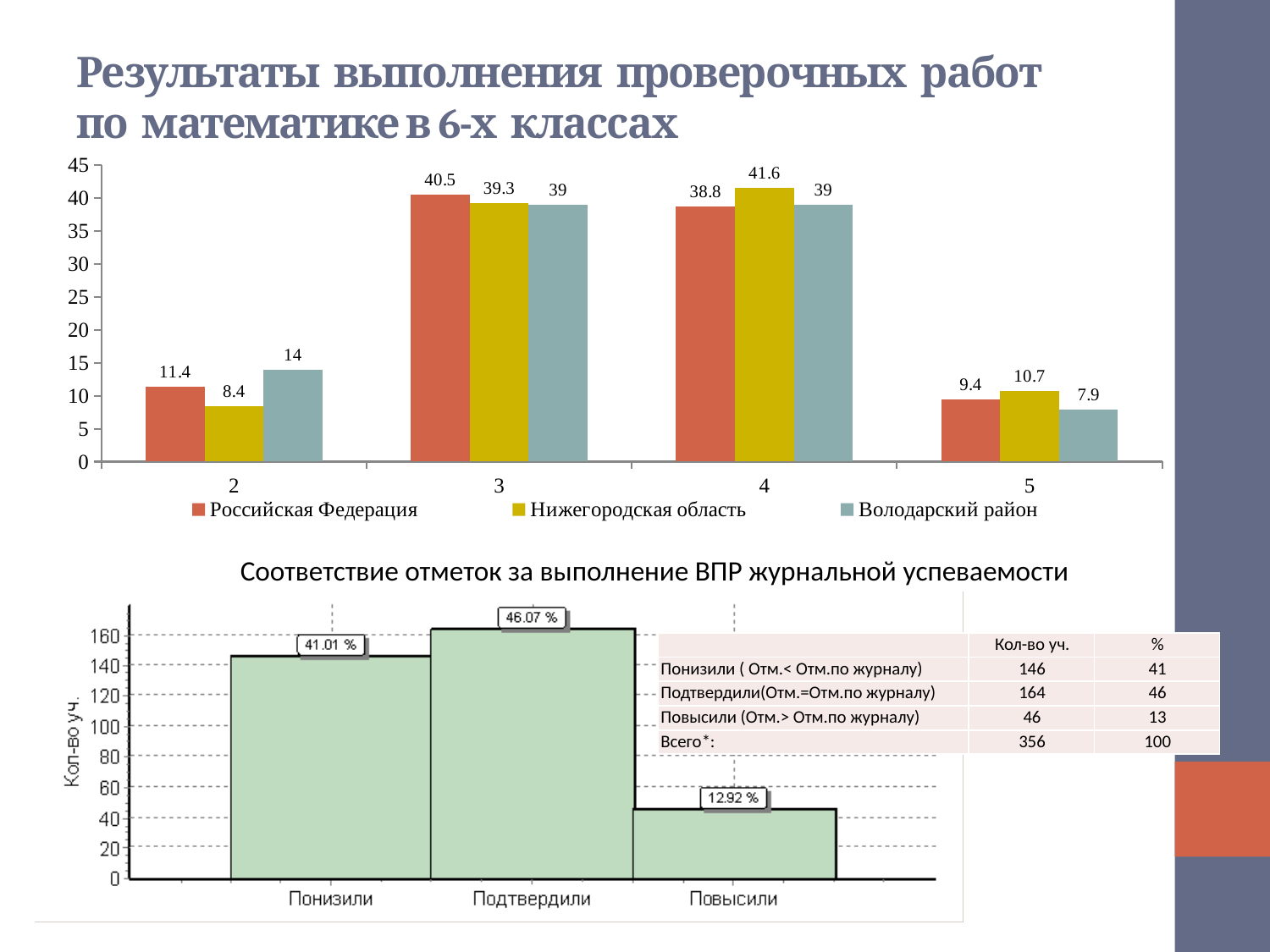
How many series does the legend of the top chart list? 3 In the bottom chart, which category has the lowest bar? Повысили In the top chart, what is the value for Володарский район at grade 2? 14 In the bottom chart (Соответствие отметок за выполнение ВПР журнальной успеваемости), what percentage is labelled on the Подтвердили bar? 46.07 % In the top chart, what is the difference between Российская Федерация and Нижегородская область at grade 2? 3 In the top chart, which series has the highest value at grade 4? Нижегородская область In the top chart, what is the value for Нижегородская область at grade 4? 41.6 What type of chart is the bottom chart? bar chart In the top chart, what is the value for Российская Федерация at grade 3? 40.5 How many grade categories are shown on the x axis of the top chart? 4 In the top chart, which grade has the lowest value for Володарский район? 5 In the top chart, which is larger at grade 5: Российская Федерация or Володарский район? Российская Федерация